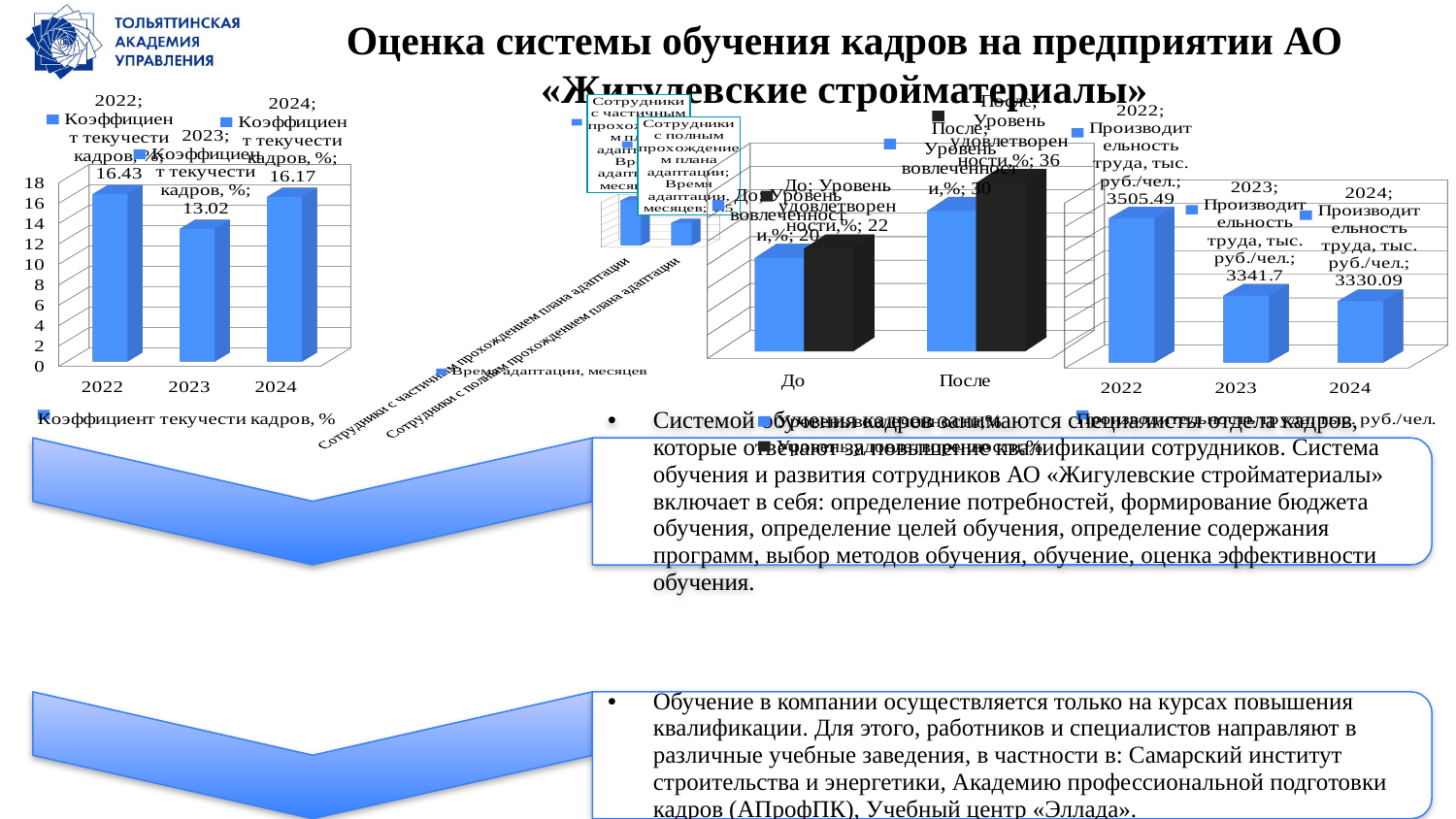
On the До/После chart, how many series does the legend list? 2 On the leftmost chart (Коэффициент текучести кадров, %), which year has the highest value? 2022 On the rightmost chart (Производительность труда, тыс. руб./чел.), what is the value for 2022? 3505.49 On the leftmost chart (Коэффициент текучести кадров, %), what is the value for 2022? 16.43 On the leftmost chart (Коэффициент текучести кадров, %), what is the difference between the 2022 and 2023 values? 3.41 On the leftmost chart (Коэффициент текучести кадров, %), which year has the lowest value? 2023 What kind of chart is the leftmost chart (Коэффициент текучести кадров, %)? bar chart On the rightmost chart (Производительность труда, тыс. руб./чел.), what is the value for 2024? 3330.09 On the leftmost chart (Коэффициент текучести кадров, %), what is the value for 2023? 13.02 On the rightmost chart (Производительность труда, тыс. руб./чел.), do the values rise or fall from 2022 to 2024? fall On the leftmost chart (Коэффициент текучести кадров, %), how many years are shown on the x axis? 3 On the До/После chart, what is the value of Уровень удовлетворенности, % for После? 36